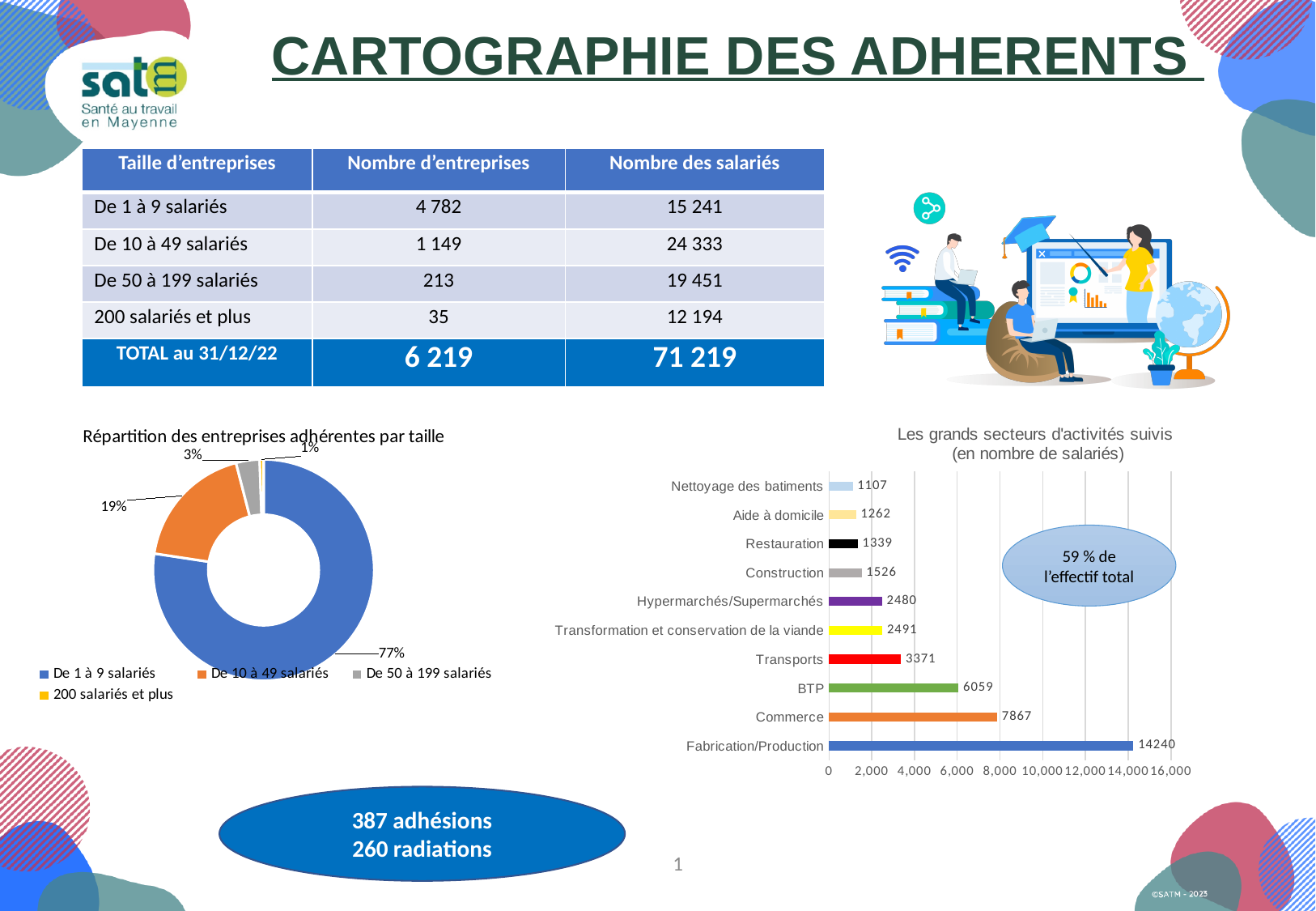
In the chart 'Les grands secteurs d'activités suivis', which is larger, BTP or Transports? BTP In the chart 'Les grands secteurs d'activités suivis', what is the value for Commerce? 7867 In the chart 'Les grands secteurs d'activités suivis', how many sectors are shown? 10 In the chart 'Les grands secteurs d'activités suivis', which sector has the highest number of salariés? Fabrication/Production What kind of chart is 'Les grands secteurs d'activités suivis'? Bar chart How many categories does the legend of 'Répartition des entreprises adhérentes par taille' list? 4 In the chart 'Les grands secteurs d'activités suivis', what is the difference between Fabrication/Production and Commerce? 6373 In the chart 'Répartition des entreprises adhérentes par taille', what share do companies with 1 to 9 salariés represent? 77% In the chart 'Les grands secteurs d'activités suivis', what is the value for Transports? 3371 What kind of chart is 'Répartition des entreprises adhérentes par taille'? Doughnut chart In the chart 'Les grands secteurs d'activités suivis', which sector has the lowest number of salariés? Nettoyage des batiments In the chart 'Répartition des entreprises adhérentes par taille', what share do companies with 10 to 49 salariés represent? 19%